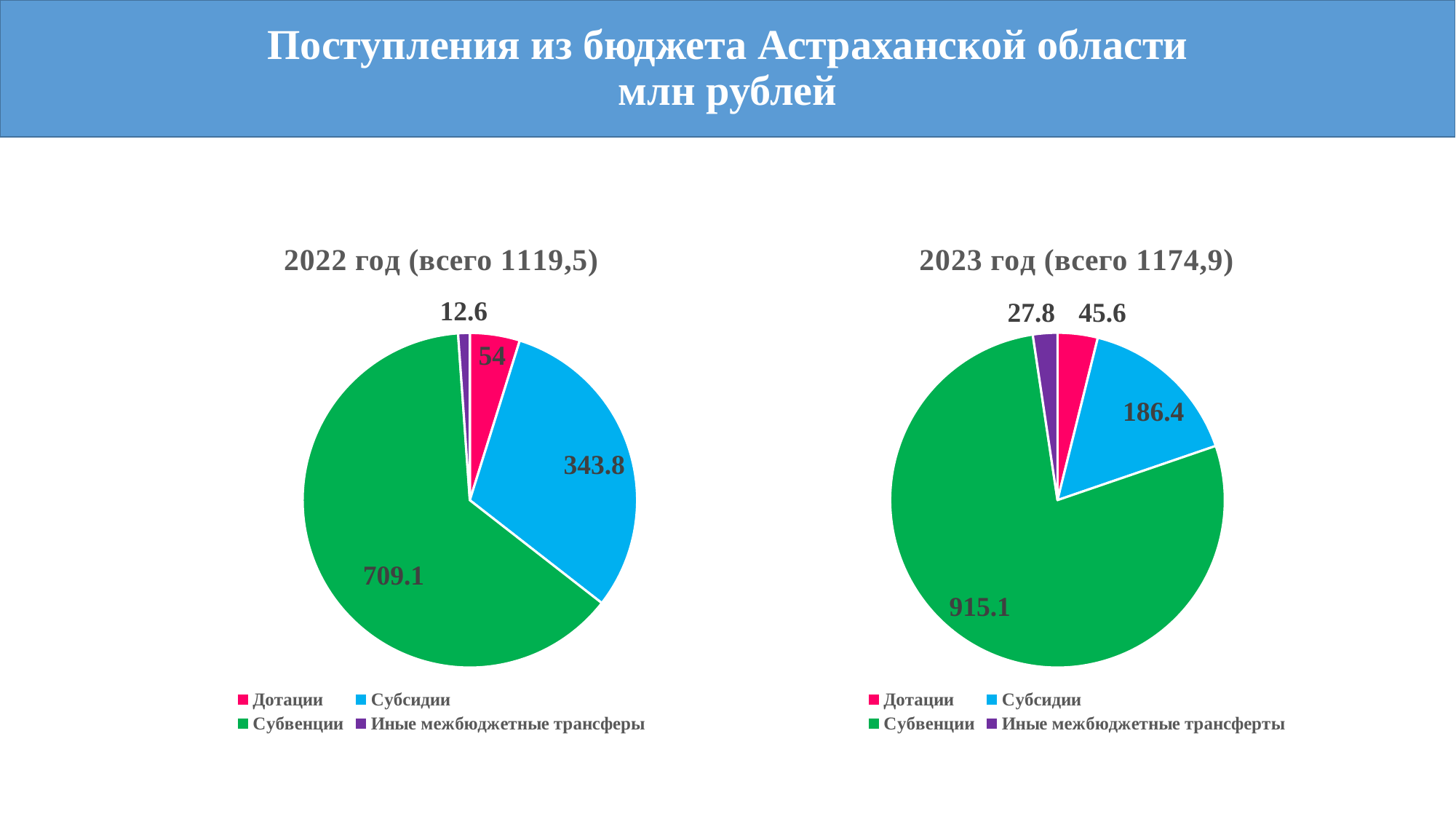
What share of the 2023 год pie does Субвенции (915.1 of 1174,9) represent, to the nearest whole percent? 78% What is the difference between the Субсидии value in the 2022 год chart and the Субсидии value in the 2023 год chart? 157.4 What type of chart is used for the 2022 год data? Pie chart Which is larger: Дотации in the 2022 год chart or Дотации in the 2023 год chart? 2022 год (54) In the 2023 год pie chart, what is the value for Дотации? 45.6 In the 2022 год pie chart, what is the value for Иные межбюджетные трансферы? 12.6 In the 2023 год pie chart, what is the value for Субвенции? 915.1 In the 2022 год pie chart, what is the value for Субсидии? 343.8 What total is stated in the title of the 2022 год pie chart? 1119,5 How many slices does the 2023 год pie chart have? 4 In the 2022 год pie chart, which category has the largest slice? Субвенции In the 2023 год pie chart, which category has the smallest slice? Иные межбюджетные трансферты